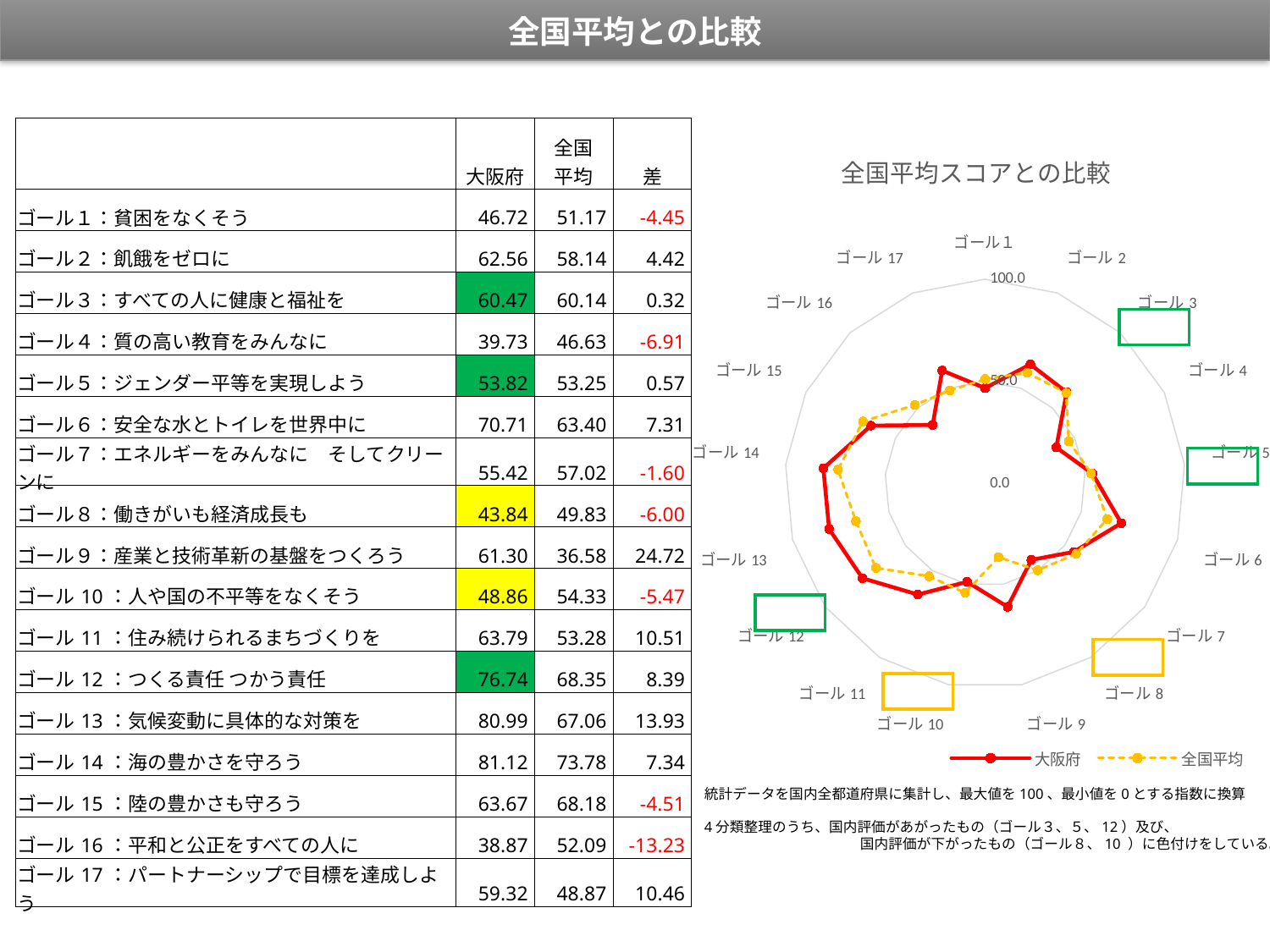
In the radar chart, which series has the larger value for ゴール16, 大阪府 or 全国平均? 全国平均 Which two series are listed in the legend of the radar chart? 大阪府 and 全国平均 According to the table, what is the 大阪府 value for ゴール9 plotted in the radar chart? 61.30 In the radar chart, is the 大阪府 value for ゴール14 greater or less than 50.0? greater What is the title of the chart on the right side of the slide? 全国平均スコアとの比較 In the radar chart, is the 全国平均 value for ゴール9 greater or less than 50.0? less In the radar chart, is the 大阪府 value for ゴール16 greater or less than 50.0? less In the radar chart, which series has the larger value for ゴール9, 大阪府 or 全国平均? 大阪府 How many categories (goals) are plotted around the radar chart? 17 What kind of chart is shown on the right side of the slide? radar chart How many series does the legend of the radar chart list? 2 For which goal is the 全国平均 value lowest in the radar chart? ゴール9